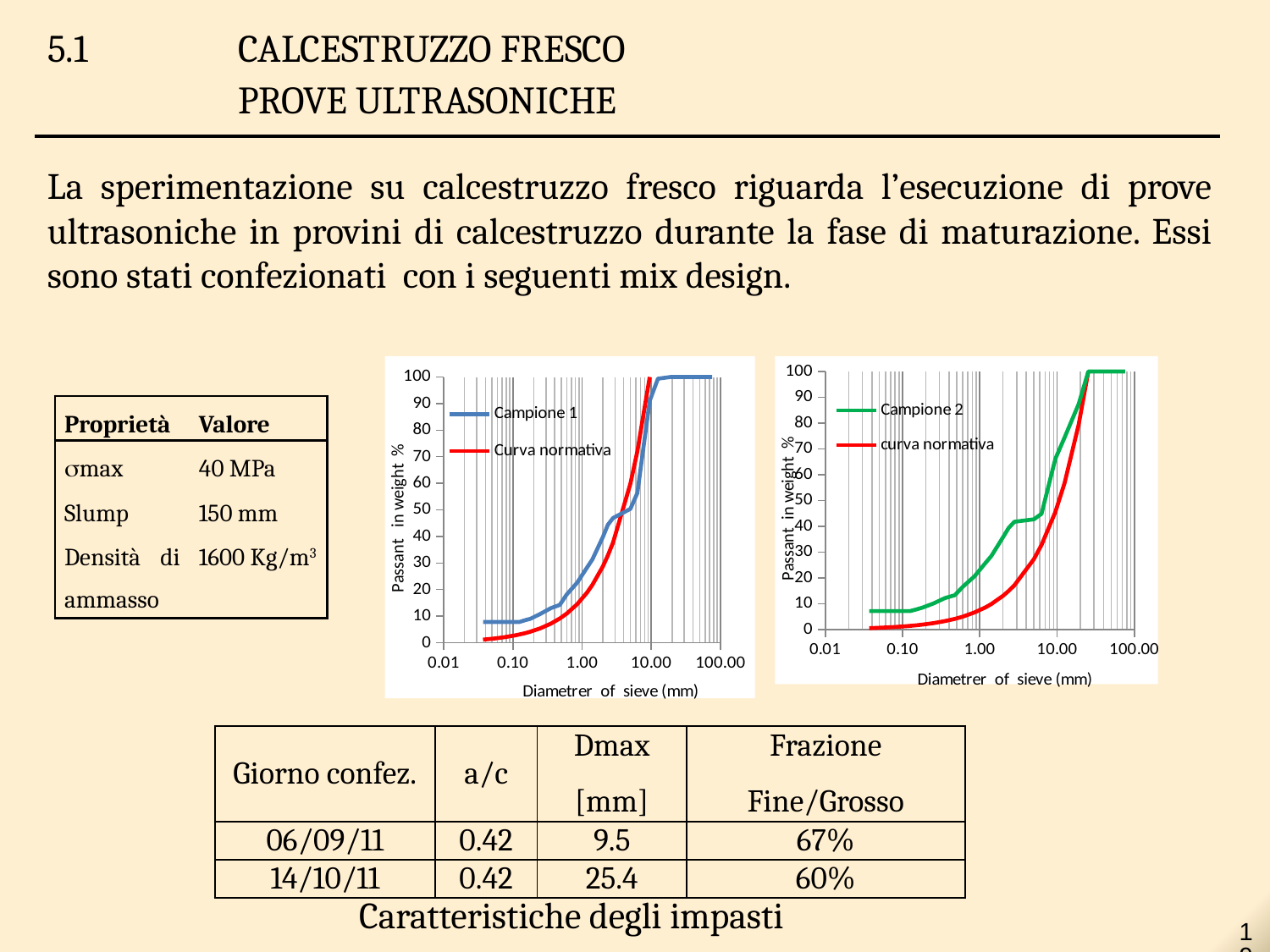
What kind of chart is the left chart (Campione 1)? line chart In the right chart, do the Campione 2 values rise or fall as the sieve diameter increases? rise In the left chart, is the value of Campione 1 at a sieve diameter of 0.10 mm greater or less than 10? less In the right chart, is the value of Campione 2 at a sieve diameter of 0.10 mm greater or less than 10? less In the right chart, at a sieve diameter of 10.00 mm, which is higher: Campione 2 or curva normativa? Campione 2 In the right chart, is the value of Campione 2 at a sieve diameter of 10.00 mm greater or less than 50? greater How many series does the legend of the right chart (Campione 2) list? 2 In the right chart, what colour is the Campione 2 line? green In the left chart, what are the two legend entries? Campione 1, Curva normativa In the left chart, at a sieve diameter of 1.00 mm, which is higher: Campione 1 or Curva normativa? Campione 1